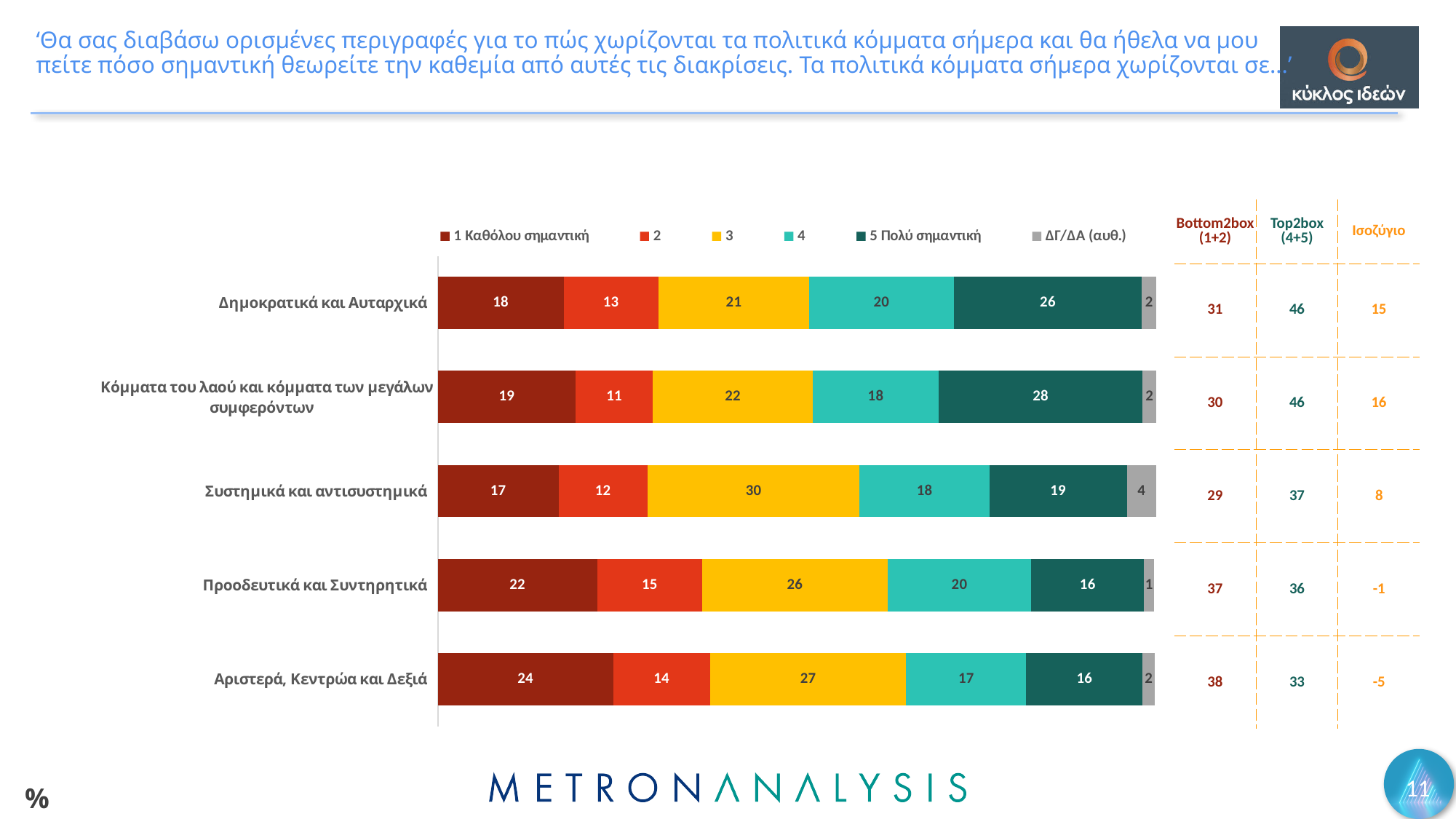
What is the value of the '3' series for 'Συστημικά και αντισυστημικά'? 30 What is the value of the '5 Πολύ σημαντική' series for 'Δημοκρατικά και Αυταρχικά'? 26 How many categories are shown in the chart? 5 What is the value of the 'ΔΓ/ΔΑ (αυθ.)' series for 'Συστημικά και αντισυστημικά'? 4 Which category has the highest value for the '1 Καθόλου σημαντική' series? Αριστερά, Κεντρώα και Δεξιά Which has the larger value for the '4' series: 'Δημοκρατικά και Αυταρχικά' or 'Αριστερά, Κεντρώα και Δεξιά'? Δημοκρατικά και Αυταρχικά What is the total of the stacked bar for 'Προοδευτικά και Συντηρητικά'? 100 How many series does the legend list? 6 Which category has the lowest value for the '2' series? Κόμματα του λαού και κόμματα των μεγάλων συμφερόντων For 'Κόμματα του λαού και κόμματα των μεγάλων συμφερόντων', what is the difference between the '5 Πολύ σημαντική' value and the '1 Καθόλου σημαντική' value? 9 Which category has the highest value for the '5 Πολύ σημαντική' series? Κόμματα του λαού και κόμματα των μεγάλων συμφερόντων What kind of chart is shown on the slide? Stacked bar chart